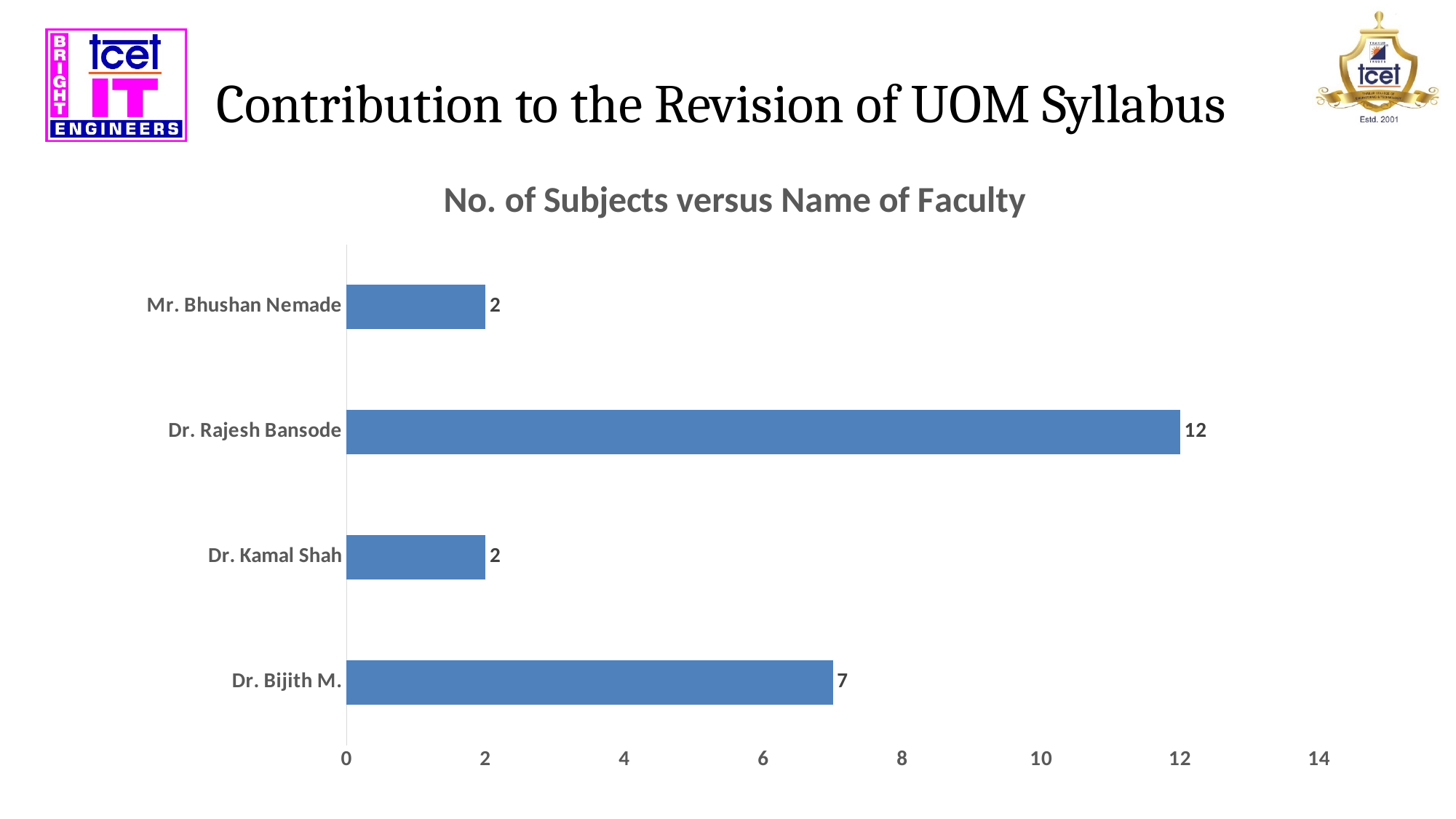
What is the title of the chart? No. of Subjects versus Name of Faculty How many faculty members are shown in the chart? 4 What is the difference between the values for Dr. Rajesh Bansode and Dr. Bijith M.? 5 What is the value for Dr. Bijith M.? 7 How many subjects did Dr. Rajesh Bansode contribute to? 12 What is the value for Dr. Kamal Shah? 2 What kind of chart is shown on the slide? bar chart Is the value for Dr. Rajesh Bansode greater or less than 10? greater Which is larger, the value for Dr. Bijith M. or the value for Mr. Bhushan Nemade? Dr. Bijith M. What is the value for Mr. Bhushan Nemade? 2 Which faculty member has the highest number of subjects? Dr. Rajesh Bansode What is the difference between the values for Dr. Bijith M. and Dr. Kamal Shah? 5